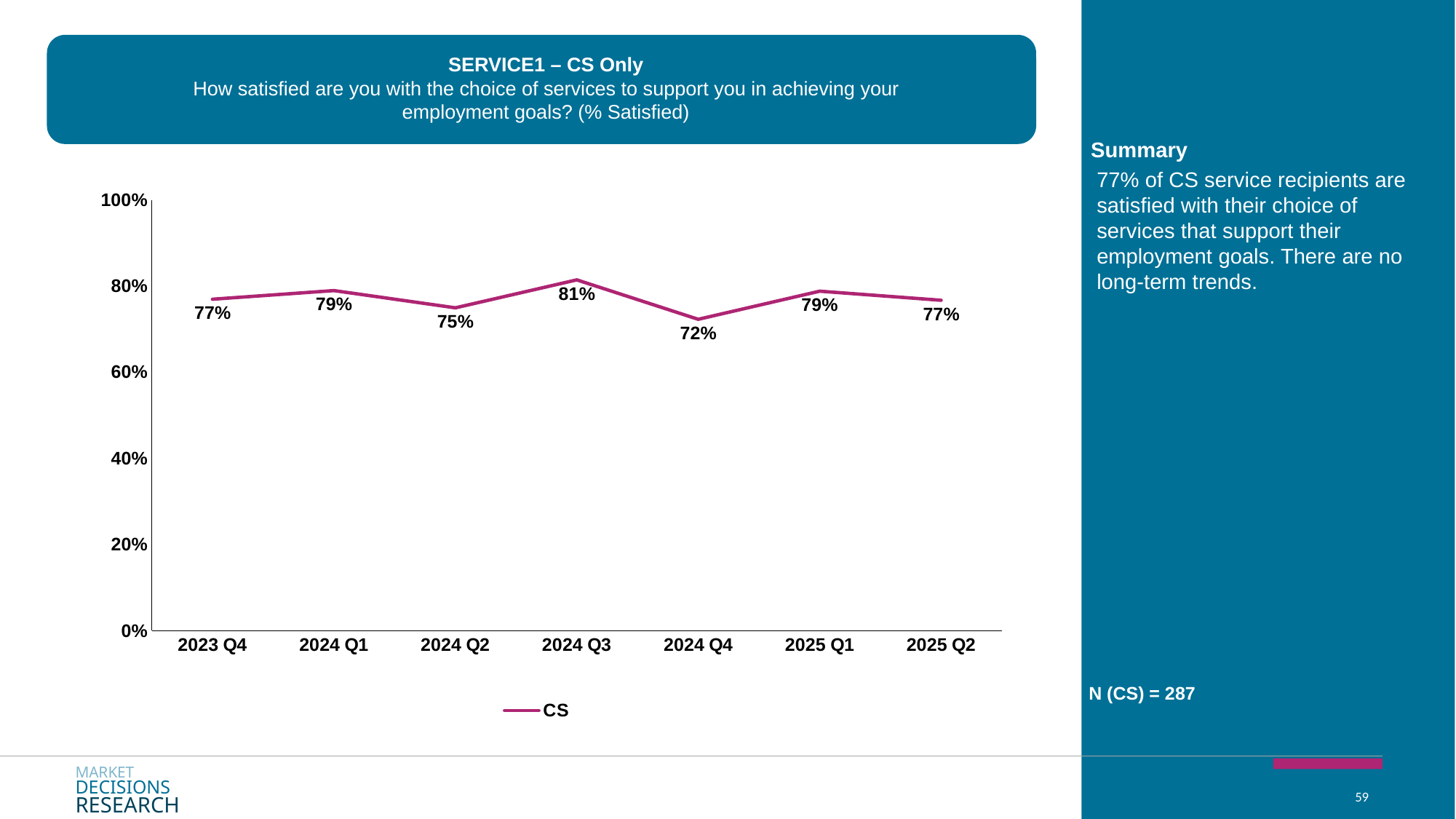
How many series does the legend list? 1 What is the value for 2024 Q4? 72% Is the value for 2025 Q1 greater or less than 60%? greater Which quarter has the highest value? 2024 Q3 Which is larger, the value for 2024 Q1 or the value for 2024 Q2? 2024 Q1 What is the value for 2024 Q3? 81% What kind of chart is shown? line chart Which quarter has the lowest value? 2024 Q4 What is the value for 2023 Q4? 77% How many quarters are plotted on the x axis? 7 What is the difference between the values for 2024 Q3 and 2024 Q4? 9% What series name is shown in the legend? CS